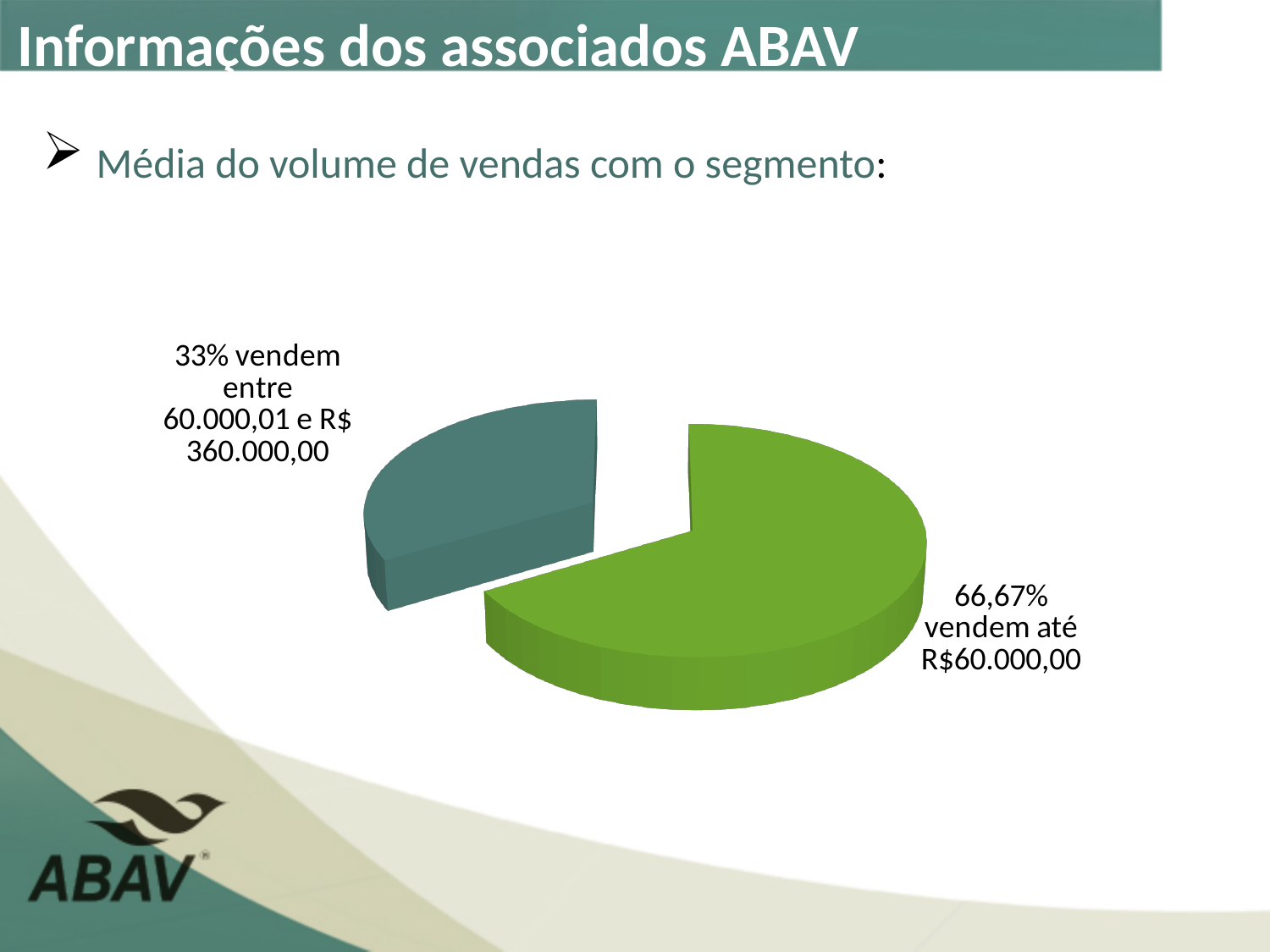
What share of associates sell up to R$60.000,00? 66,67% Which slice is the smallest in the pie chart? 33% vendem entre 60.000,01 e R$ 360.000,00 What share of associates sell between 60.000,01 and R$ 360.000,00? 33% Which slice is the largest in the pie chart? 66,67% vendem até R$60.000,00 What kind of chart is shown on the slide? pie chart What colour is the slice for associates selling up to R$60.000,00? green How many slices does the pie chart have? 2 Is the share of associates selling up to R$60.000,00 greater or less than 50%? greater Which is larger: the share selling up to R$60.000,00 or the share selling between 60.000,01 and R$ 360.000,00? up to R$60.000,00 What is the bullet text describing the chart? Média do volume de vendas com o segmento: